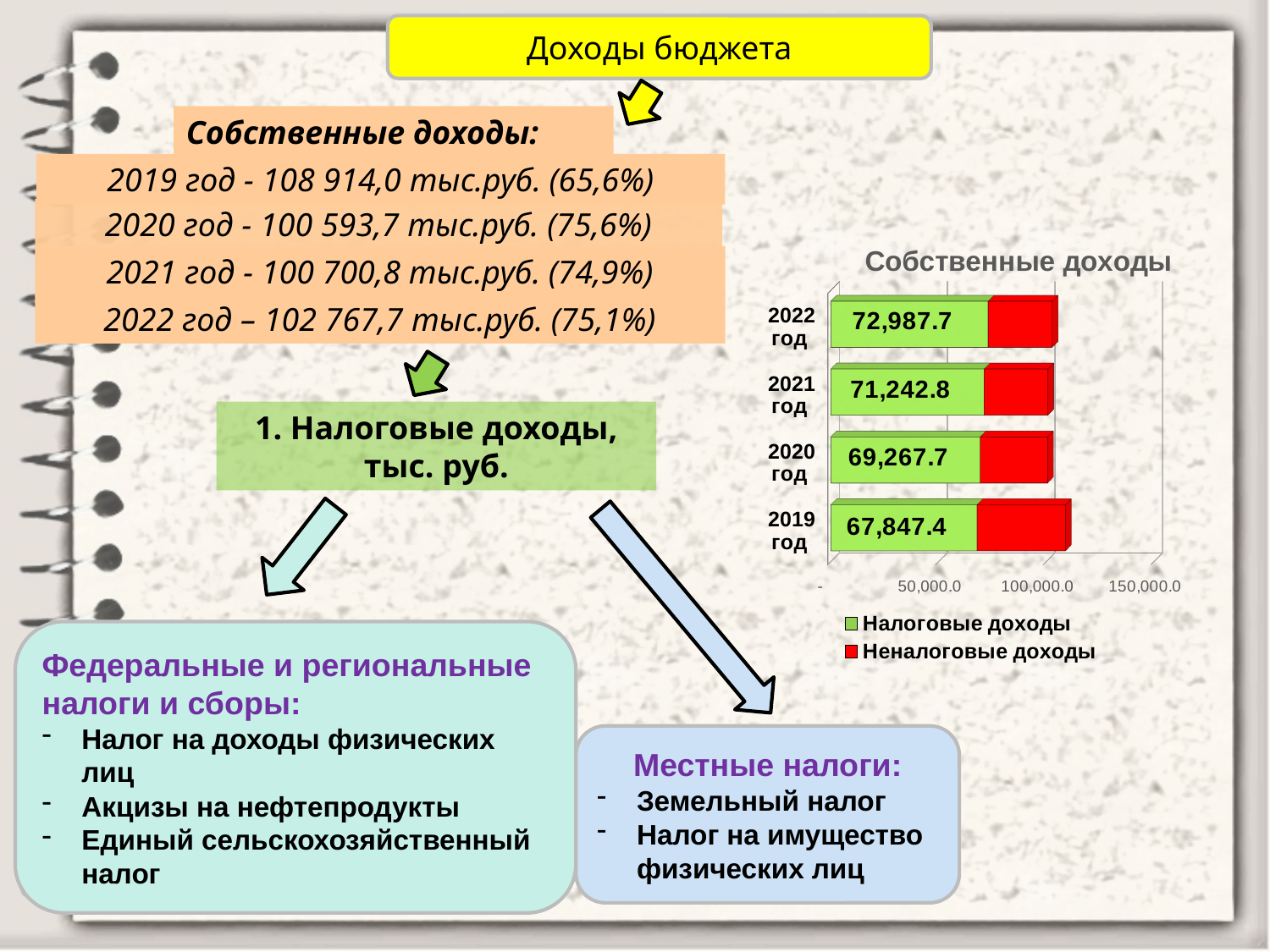
What type of chart is the Собственные доходы chart? Stacked bar chart How many series does the legend of the Собственные доходы chart list? 2 Which year has the lowest Налоговые доходы in the Собственные доходы chart? 2019 год What is the value of Налоговые доходы for 2020 год in the Собственные доходы chart? 69,267.7 What is the value of Налоговые доходы for 2022 год in the Собственные доходы chart? 72,987.7 What is the difference in Налоговые доходы between 2022 год and 2019 год in the Собственные доходы chart? 5,140.3 What is the value of Налоговые доходы for 2019 год in the Собственные доходы chart? 67,847.4 In the Собственные доходы chart, is the Налоговые доходы value for 2019 год greater or less than 50,000.0? greater Which colour represents Неналоговые доходы in the Собственные доходы chart? Red Which is larger in the Собственные доходы chart: Налоговые доходы for 2021 год or for 2020 год? 2021 год Which year has the highest Налоговые доходы in the Собственные доходы chart? 2022 год How many years are shown in the Собственные доходы chart? 4